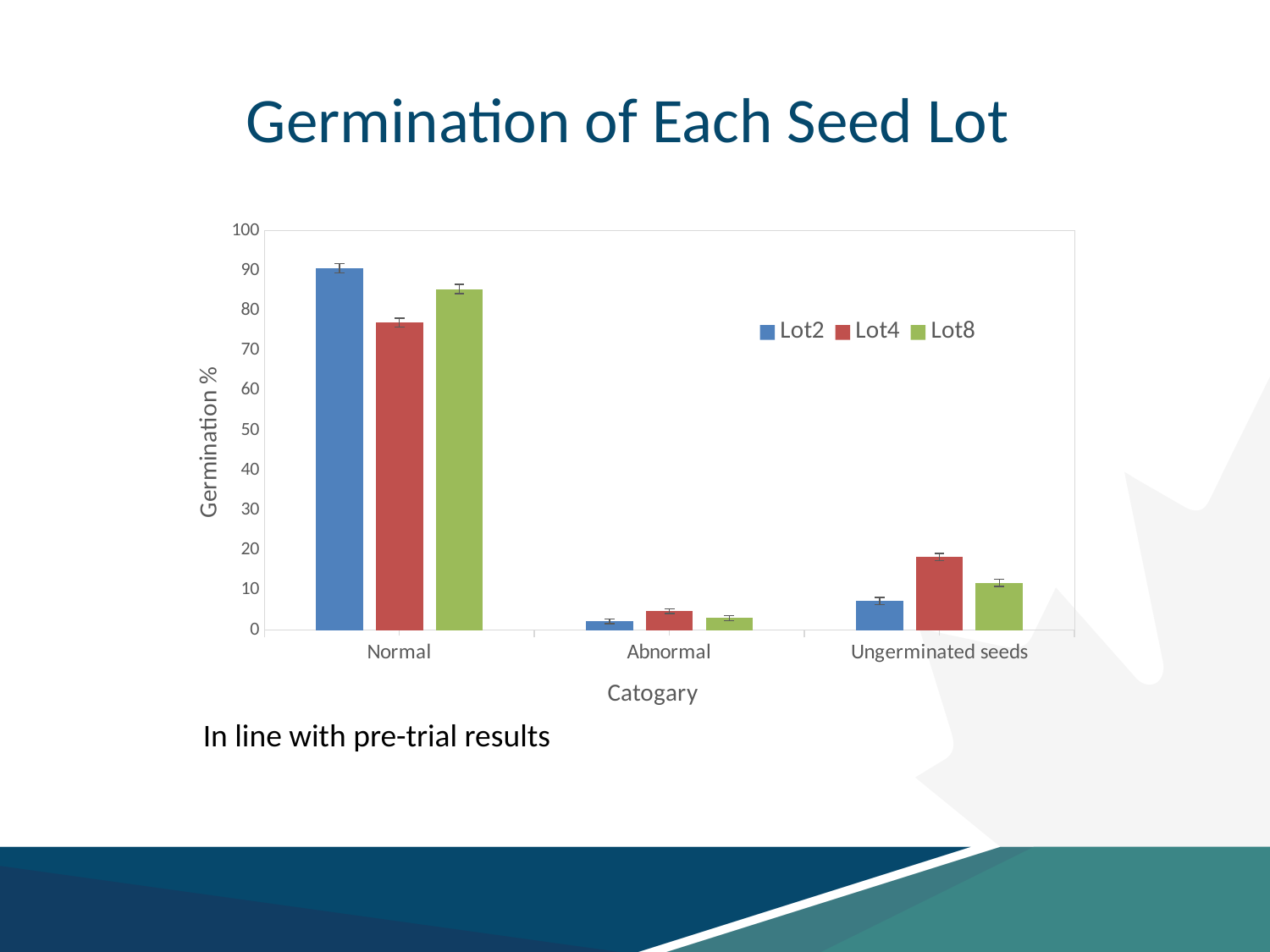
Which is larger in the Normal category, Lot8 or Lot4? Lot8 Which lot has the highest value in the Ungerminated seeds category? Lot4 Which lot has the lowest value in the Abnormal category? Lot2 How many series does the legend list? 3 How many categories are shown on the x axis? 3 Is the value for Lot8 in the Abnormal category greater or less than 10? less What kind of chart is shown on the slide? bar chart Is the value for Lot4 in the Ungerminated seeds category greater or less than 10? greater Is the value for Lot2 in the Normal category greater or less than 80? greater Which lot has the lowest value in the Normal category? Lot4 What is the label on the y axis of the chart? Germination % Which lot has the highest germination value in the Normal category? Lot2